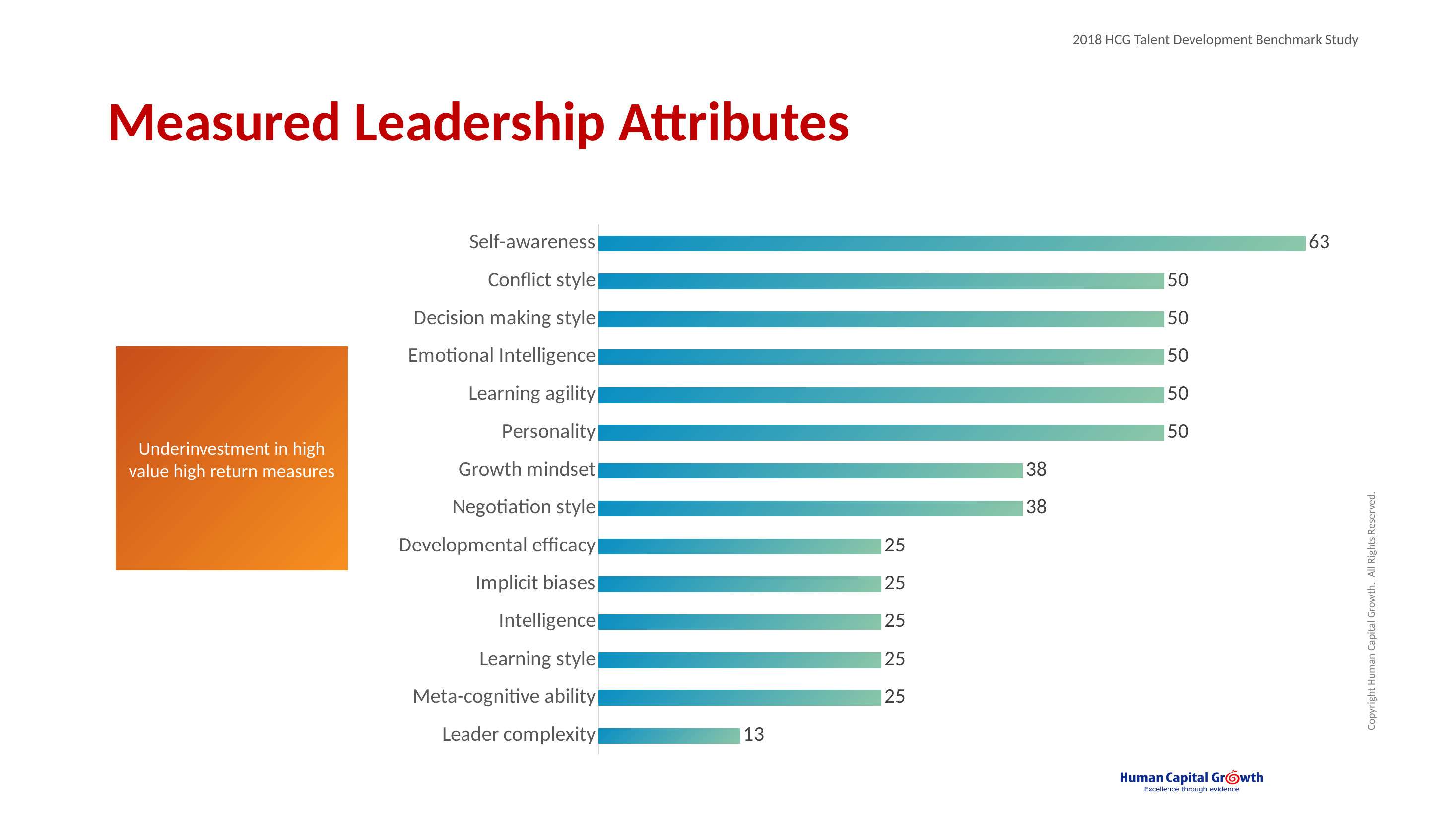
What is the value for Implicit biases? 25 What kind of chart is shown on the slide? Bar chart What is the value for Self-awareness? 63 What is the difference between the values for Negotiation style and Leader complexity? 25 Which is larger, the value for Personality or the value for Developmental efficacy? Personality How many categories are shown in the chart? 14 Which category has the lowest value? Leader complexity What is the value for Growth mindset? 38 Which category has the highest value? Self-awareness What is the value for Leader complexity? 13 What is the difference between the values for Self-awareness and Conflict style? 13 How many categories have a value of 50? 5